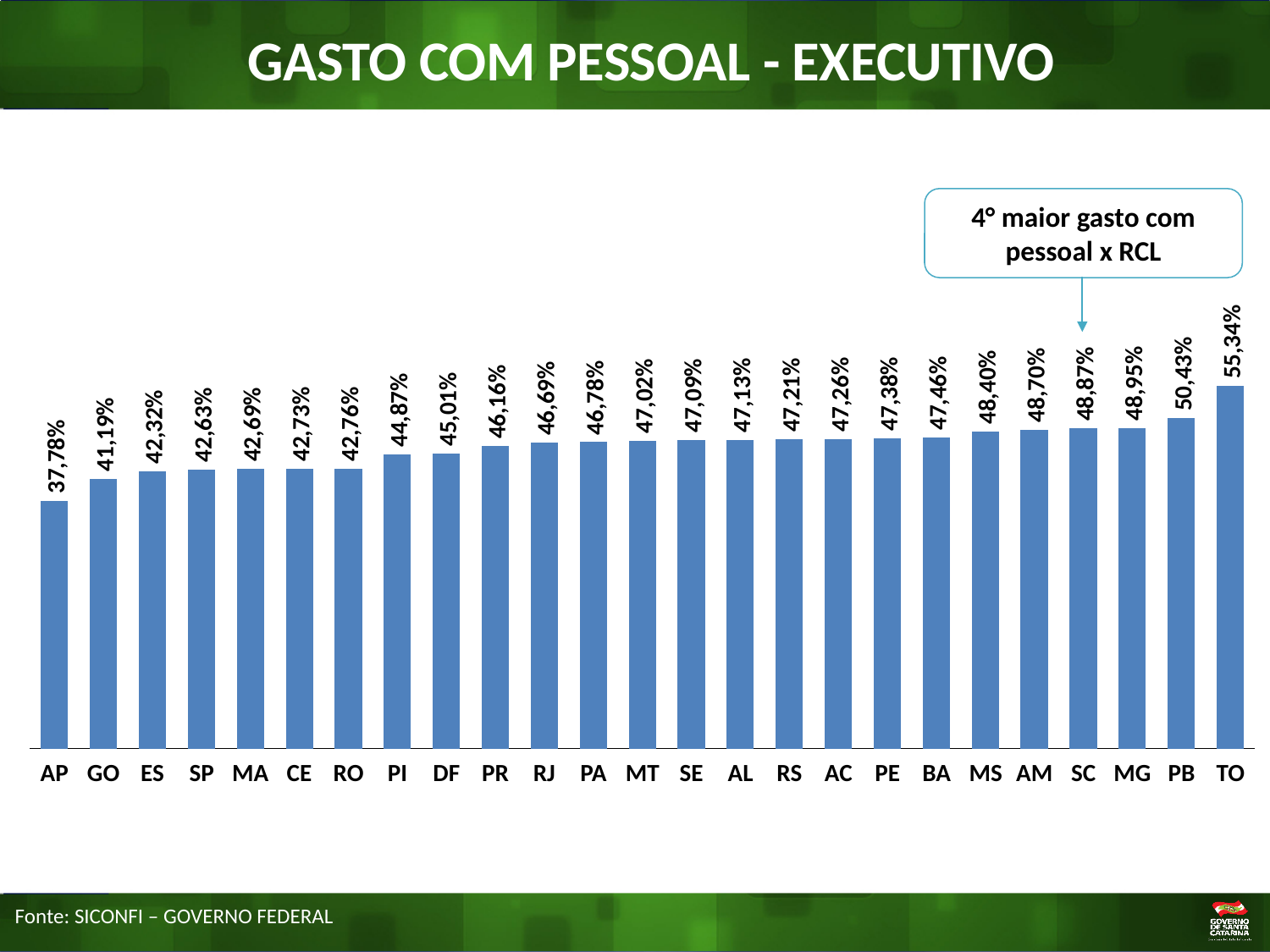
Which state has the lowest value? AP What is the value for SC? 48,87% What is the title of the chart? GASTO COM PESSOAL - EXECUTIVO What is the difference between the values for TO and AP? 17,56 percentage points What is the difference between the values for PB and SC? 1,56 percentage points What kind of chart is shown? Bar chart What is the value for AP? 37,78% Which state has the highest value? TO How many states are shown on the chart? 25 Do the values rise or fall from left to right along the x axis? Rise Which is larger, the value for PB or the value for MG? PB What is the value for PB? 50,43%